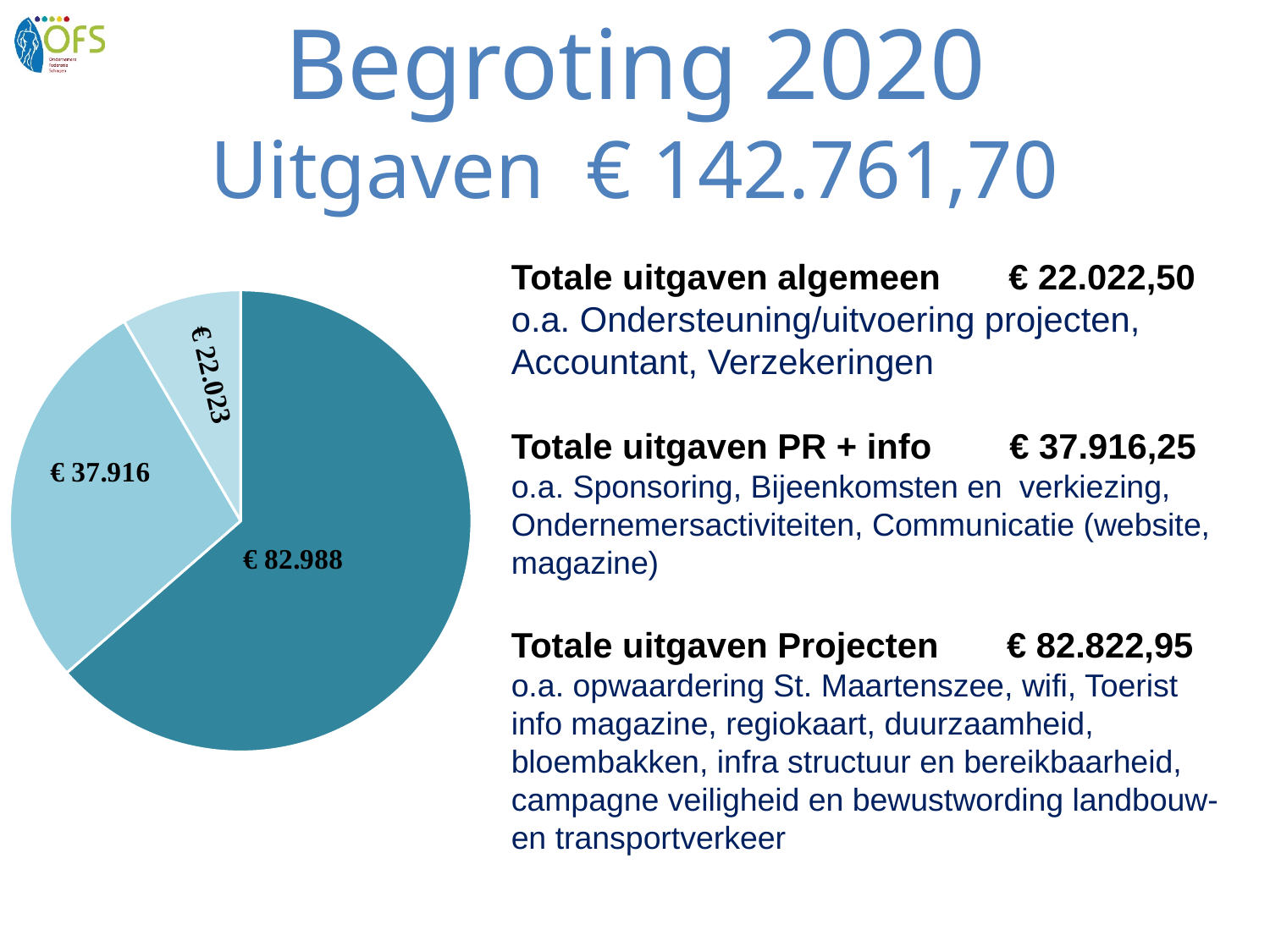
What is the difference between the € 82.988 slice and the € 37.916 slice? € 45.072 How many slices does the pie chart have? 3 What is the difference between the € 37.916 slice and the € 22.023 slice? € 15.893 What value is printed on the lightest-coloured slice of the pie chart? € 22.023 Which slice is larger: the medium light-blue slice or the lightest slice? the medium light-blue slice (€ 37.916) What is the value printed on the smallest slice of the pie chart? € 22.023 What value is printed on the medium light-blue slice on the left of the pie chart? € 37.916 What value is printed on the dark teal slice of the pie chart? € 82.988 What is the value printed on the largest slice of the pie chart? € 82.988 Does the € 82.988 slice cover more or less than half of the pie? more What kind of chart is shown on the slide? pie chart What colour is the largest slice of the pie chart? dark teal